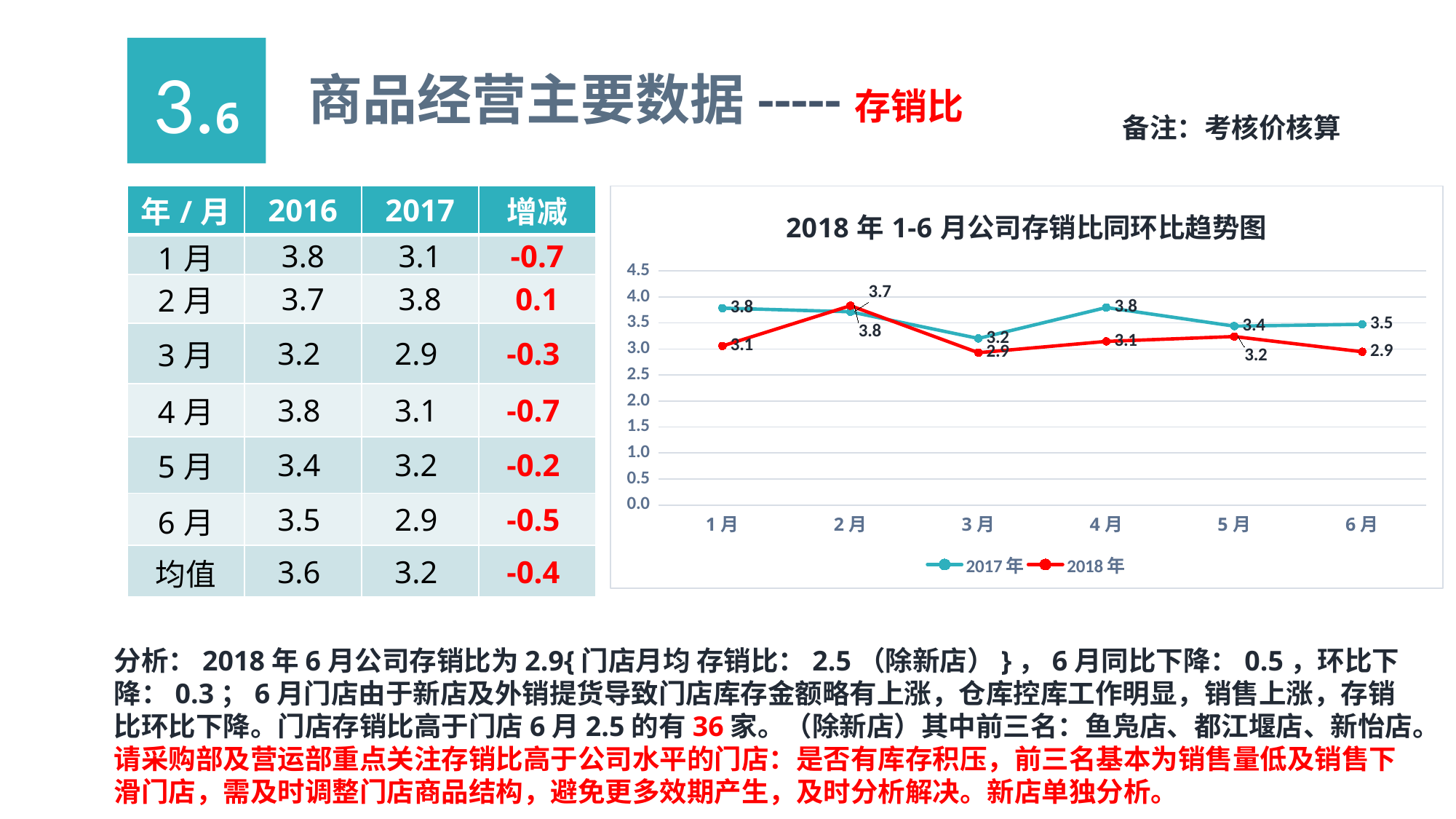
这是什么类型的图表？ 折线图 图表的横轴上共有多少个月份？ 6 图表中2017年5月的存销比是多少？ 3.4 图表的标题是什么？ 2018年1-6月公司存销比同环比趋势图 图表中2018年2月的存销比是多少？ 3.8 图表中1月份2017年与2018年的存销比相差多少？ 0.7 图表中6月份2017年和2018年哪个系列的存销比更高？ 2017年 图表中2017年系列哪个月的存销比最低？ 3月 图表的图例中列出了几个系列？ 2 图表中2018年系列哪个月的存销比最高？ 2月 图表中2017年4月的存销比是多少？ 3.8 图表中2018年3月的存销比是多少？ 2.9